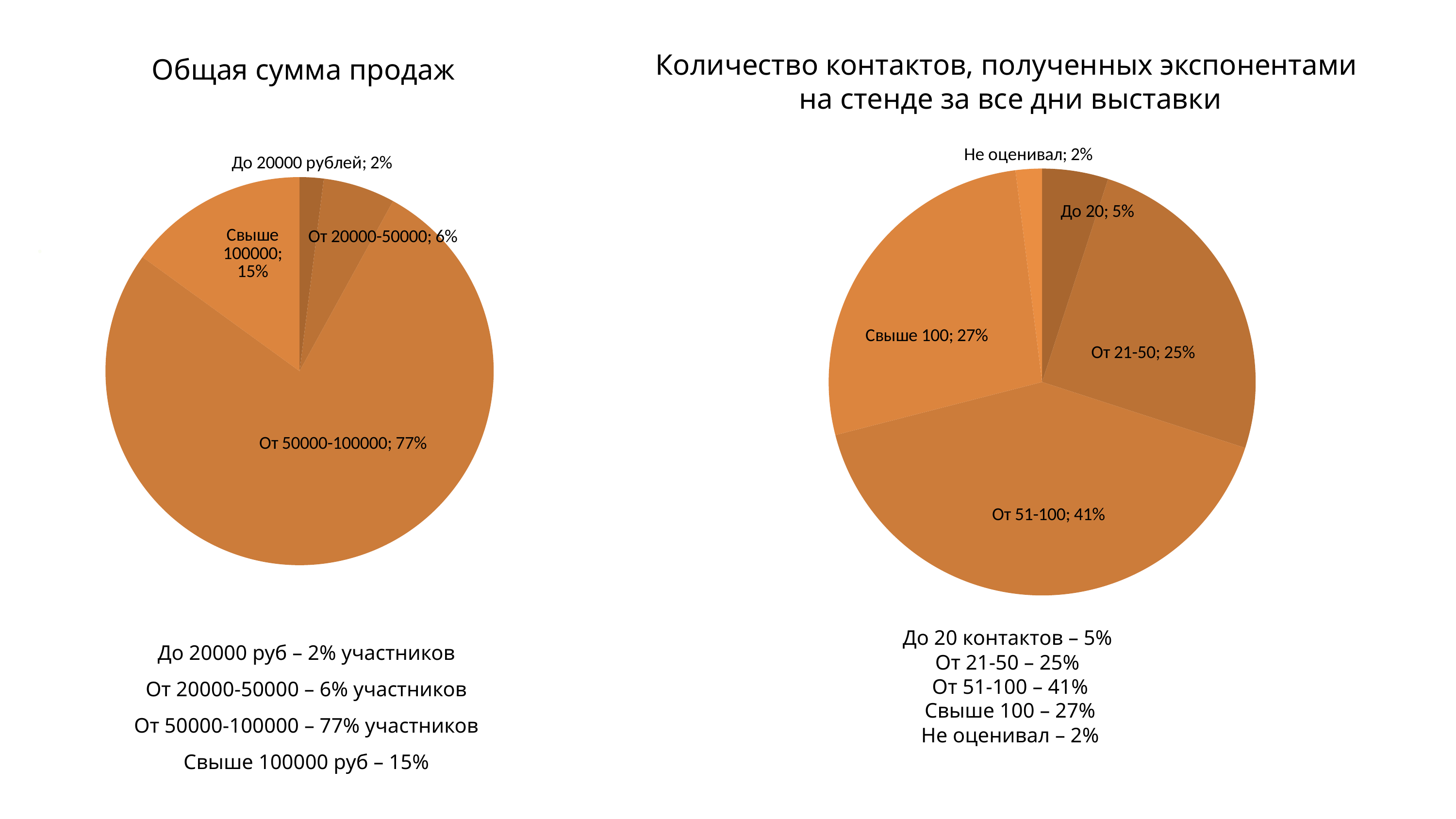
In the 'Количество контактов, полученных экспонентами на стенде за все дни выставки' chart, which category has the largest slice? От 51-100 In the 'Общая сумма продаж' chart, what is the difference between the shares for 'От 50000-100000' and 'Свыше 100000'? 62% In the 'Общая сумма продаж' chart, how many slices does the pie have? 4 In the 'Количество контактов, полученных экспонентами на стенде за все дни выставки' chart, how many slices does the pie have? 5 In the 'Количество контактов, полученных экспонентами на стенде за все дни выставки' chart, which is larger: 'Свыше 100' or 'От 21-50'? Свыше 100 What kind of chart is 'Общая сумма продаж'? Pie chart In the 'Общая сумма продаж' chart, which category has the smallest slice? До 20000 рублей In the 'Количество контактов, полученных экспонентами на стенде за все дни выставки' chart, what is the difference between the shares for 'От 51-100' and 'От 21-50'? 16% In the 'Общая сумма продаж' chart, what share is labelled for 'Свыше 100000'? 15% In the 'Количество контактов, полученных экспонентами на стенде за все дни выставки' chart, what share is labelled for 'От 51-100'? 41% In the 'Количество контактов, полученных экспонентами на стенде за все дни выставки' chart, what share is labelled for 'До 20'? 5% In the 'Общая сумма продаж' chart, what share is labelled for 'От 50000-100000'? 77%